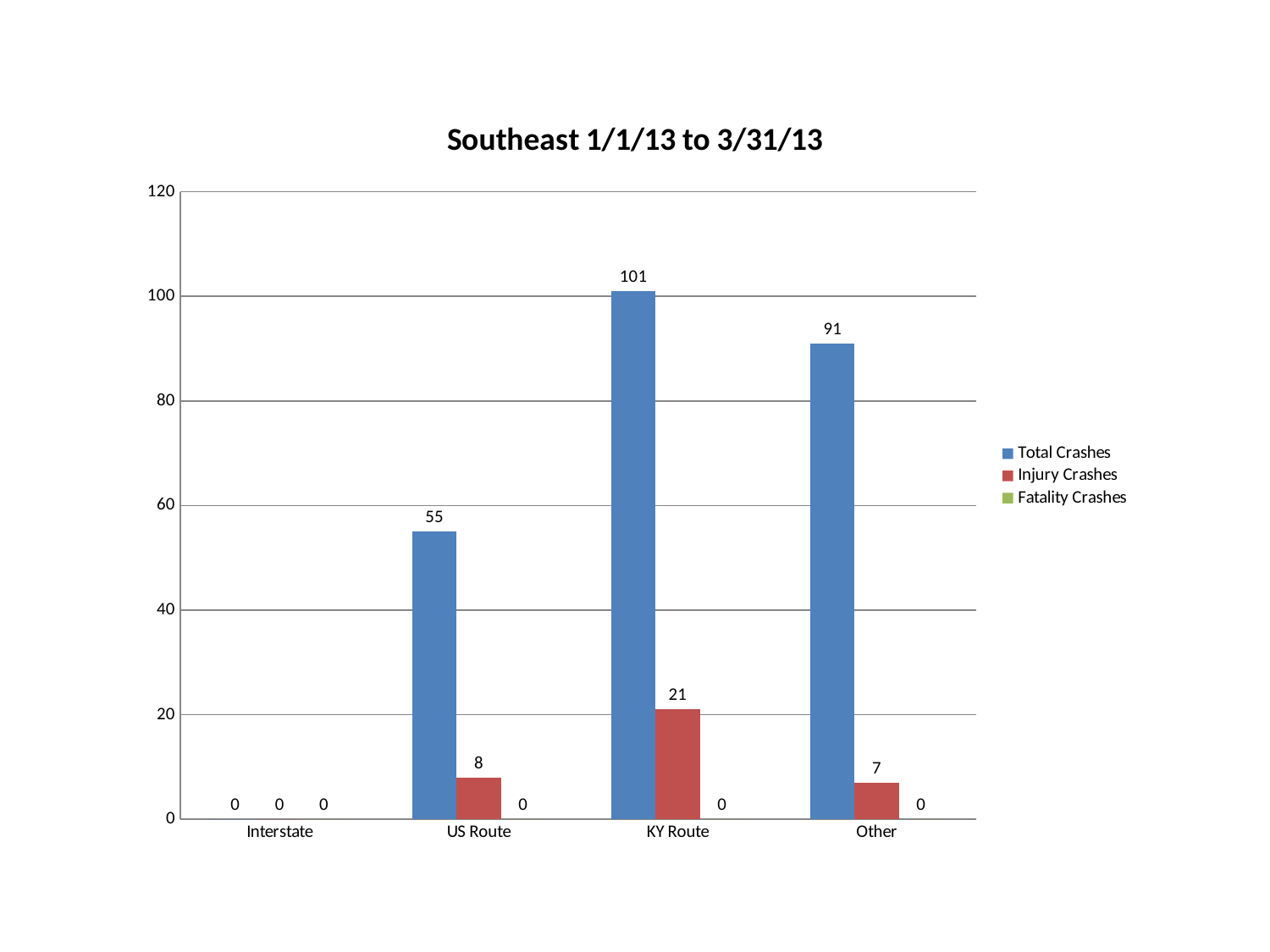
What kind of chart is shown on the slide? Bar chart What is the value of Total Crashes for Other? 91 What is the title of the chart? Southeast 1/1/13 to 3/31/13 Which category has the highest Total Crashes? KY Route What is the difference between Total Crashes for KY Route and Other? 10 How many series does the legend list? 3 Which category has the lowest Injury Crashes? Interstate What is the value of Fatality Crashes for KY Route? 0 How many categories are shown on the x axis? 4 What is the value of Total Crashes for KY Route? 101 Which is larger: Injury Crashes for KY Route or Injury Crashes for Other? KY Route What is the value of Injury Crashes for US Route? 8